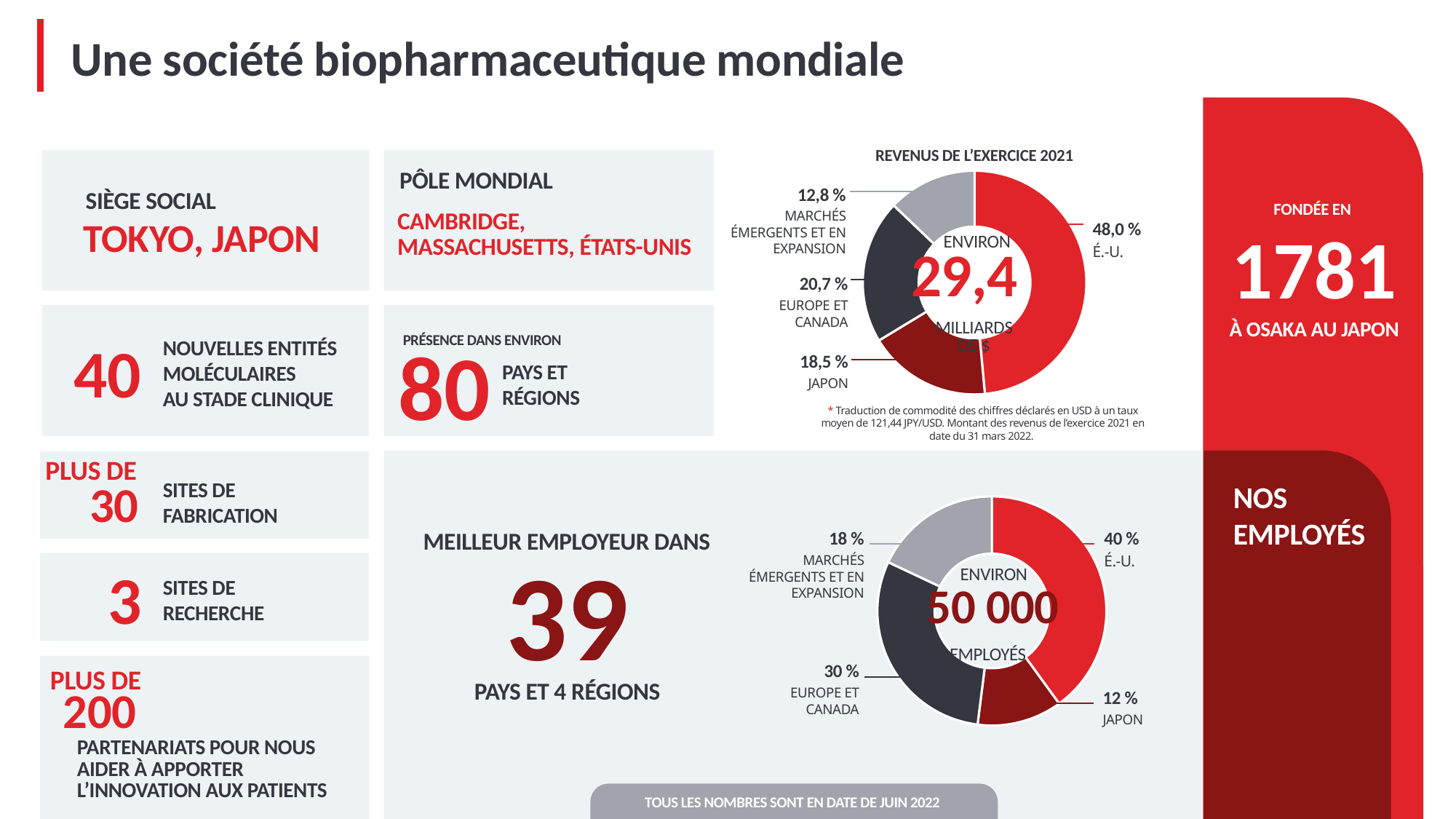
What approximate total is shown in the centre of the employees chart at the bottom of the slide? Environ 50 000 employés In the 'REVENUS DE L'EXERCICE 2021' chart, which region has the smallest share? Marchés émergents et en expansion How many segments does the 'REVENUS DE L'EXERCICE 2021' chart have? 4 What kind of chart is the 'REVENUS DE L'EXERCICE 2021' chart? Donut (pie) chart In the 'REVENUS DE L'EXERCICE 2021' chart, what is the difference between the É.-U. share and the Japon share? 29,5 % In the 'REVENUS DE L'EXERCICE 2021' chart, what share of revenue comes from Europe et Canada? 20,7 % In the employees chart at the bottom of the slide, what is the difference between the É.-U. share and the Europe et Canada share? 10 % In the employees chart at the bottom of the slide, which is larger: the share for Marchés émergents et en expansion or the share for Japon? Marchés émergents et en expansion In the employees chart at the bottom of the slide, which region has the largest share? É.-U. In the employees chart at the bottom of the slide, what share of employees is in Europe et Canada? 30 % In the 'REVENUS DE L'EXERCICE 2021' chart, what share of revenue comes from É.-U.? 48,0 % In the employees chart at the bottom of the slide, what share of employees is in Japon? 12 %